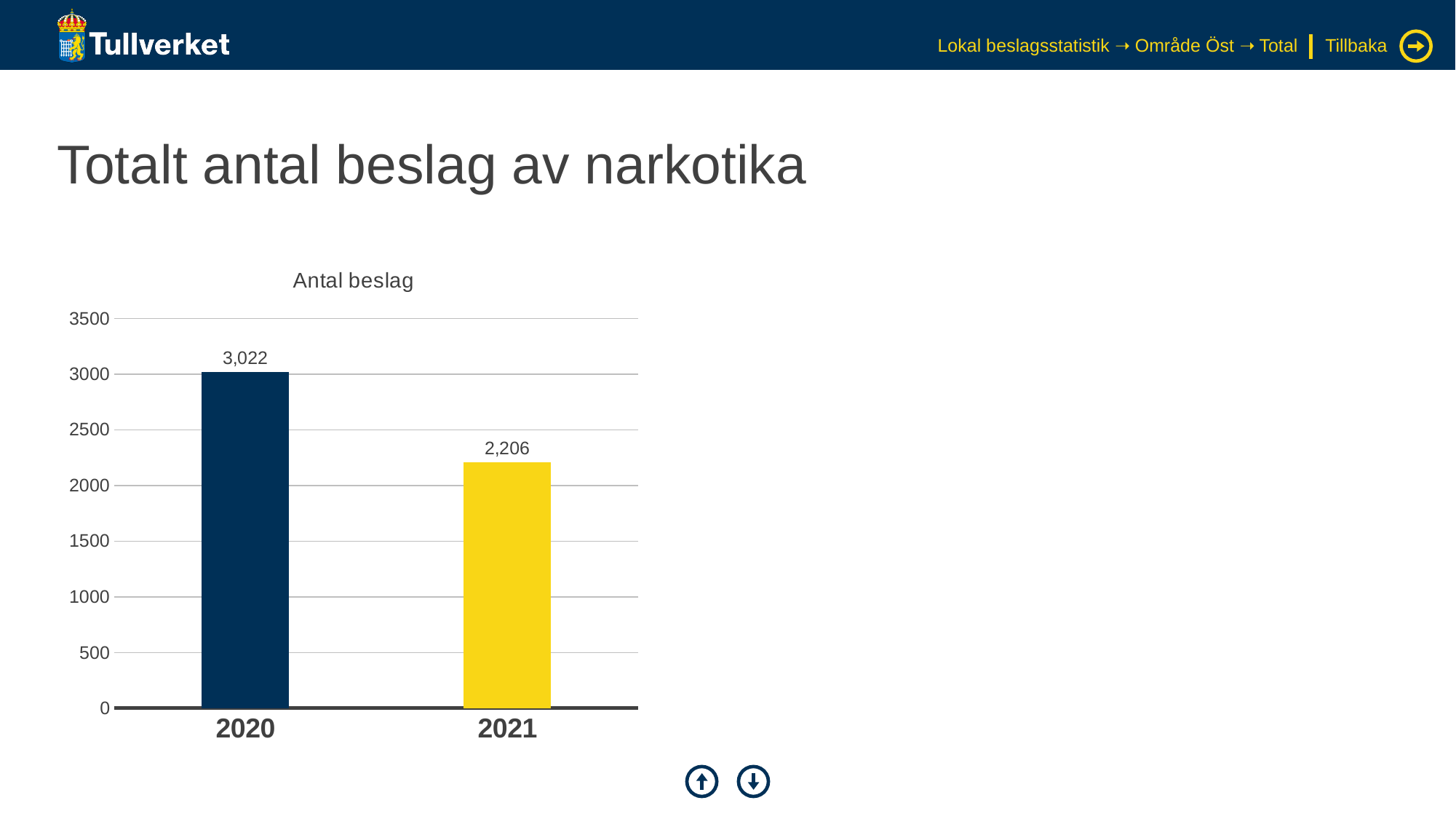
Which is larger, the value for 2020 or the value for 2021? 2020 What kind of chart is shown? bar chart How many years are shown on the x axis? 2 What is the value for 2021? 2,206 Which year has the highest number of seizures? 2020 Is the value for 2020 greater or less than 3000? greater Is the value for 2021 greater or less than 2500? less Which year has the lowest number of seizures? 2021 What is the title of the chart? Antal beslag What is the value for 2020? 3,022 What is the difference between the values for 2020 and 2021? 816 Do the values rise or fall from 2020 to 2021? fall